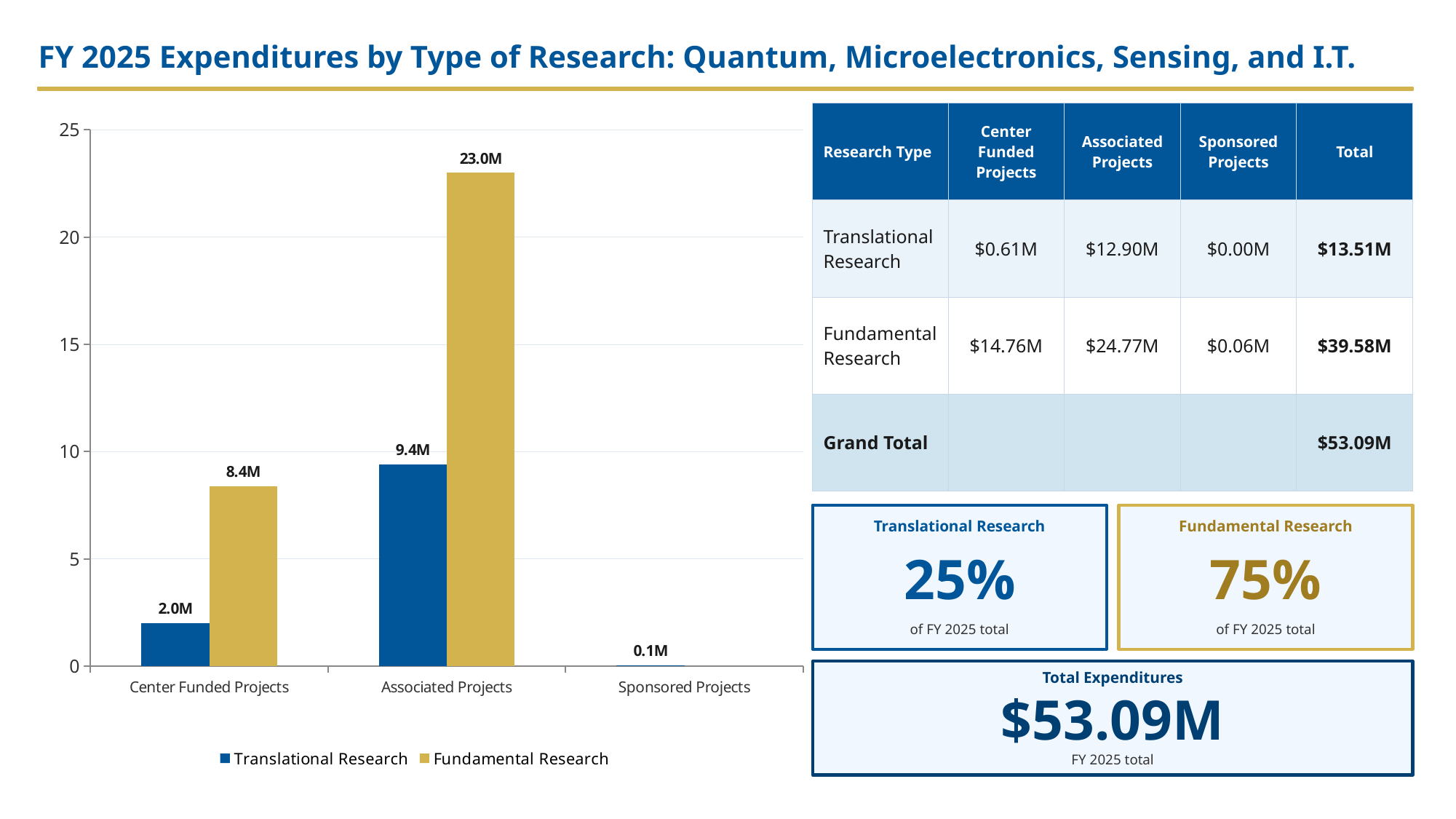
For Center Funded Projects, which series is larger: Translational Research or Fundamental Research? Fundamental Research Is the Fundamental Research value for Associated Projects greater or less than 20? greater What is the Translational Research value for Center Funded Projects? 2.0M What is the Fundamental Research value for Associated Projects? 23.0M How many series does the chart legend list? 2 How many project categories are shown on the x axis of the chart? 3 What is the Fundamental Research value for Center Funded Projects? 8.4M What is the difference between the Fundamental Research and Translational Research values for Associated Projects? 13.6M Which project category has the lowest Translational Research expenditure? Sponsored Projects What is the Translational Research value for Associated Projects? 9.4M What kind of chart is shown on the slide? bar chart Which project category has the highest Fundamental Research expenditure? Associated Projects